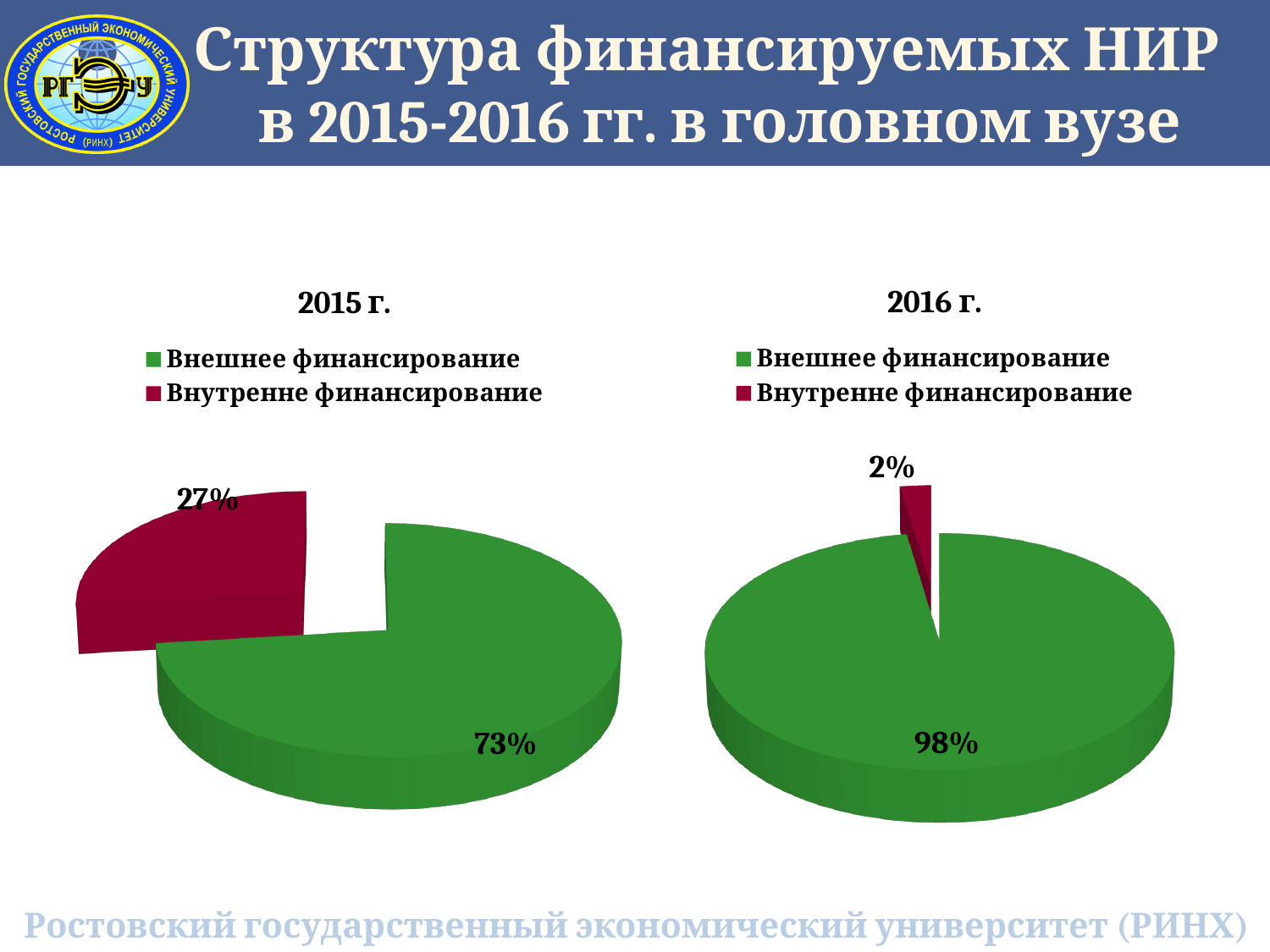
In the "2015 г." chart, what is the difference in percentage points between "Внешнее финансирование" and "Внутренне финансирование"? 46 In the "2016 г." chart, which category has the smallest slice? Внутренне финансирование In the "2015 г." chart, which category has the largest slice? Внешнее финансирование In the "2015 г." chart, what colour is the "Внутренне финансирование" slice? Dark red In the "2016 г." chart, what share does "Внешнее финансирование" have? 98% Which is larger: "Внутренне финансирование" in the "2015 г." chart or "Внутренне финансирование" in the "2016 г." chart? 2015 г. In the "2015 г." chart, what share does "Внутренне финансирование" have? 27% How many entries does the legend of the "2016 г." chart list? 2 What kind of chart is the "2016 г." chart? Pie chart How many slices does the "2015 г." chart have? 2 In the "2016 г." chart, what share does "Внутренне финансирование" have? 2% In the "2015 г." chart, what share does "Внешнее финансирование" have? 73%